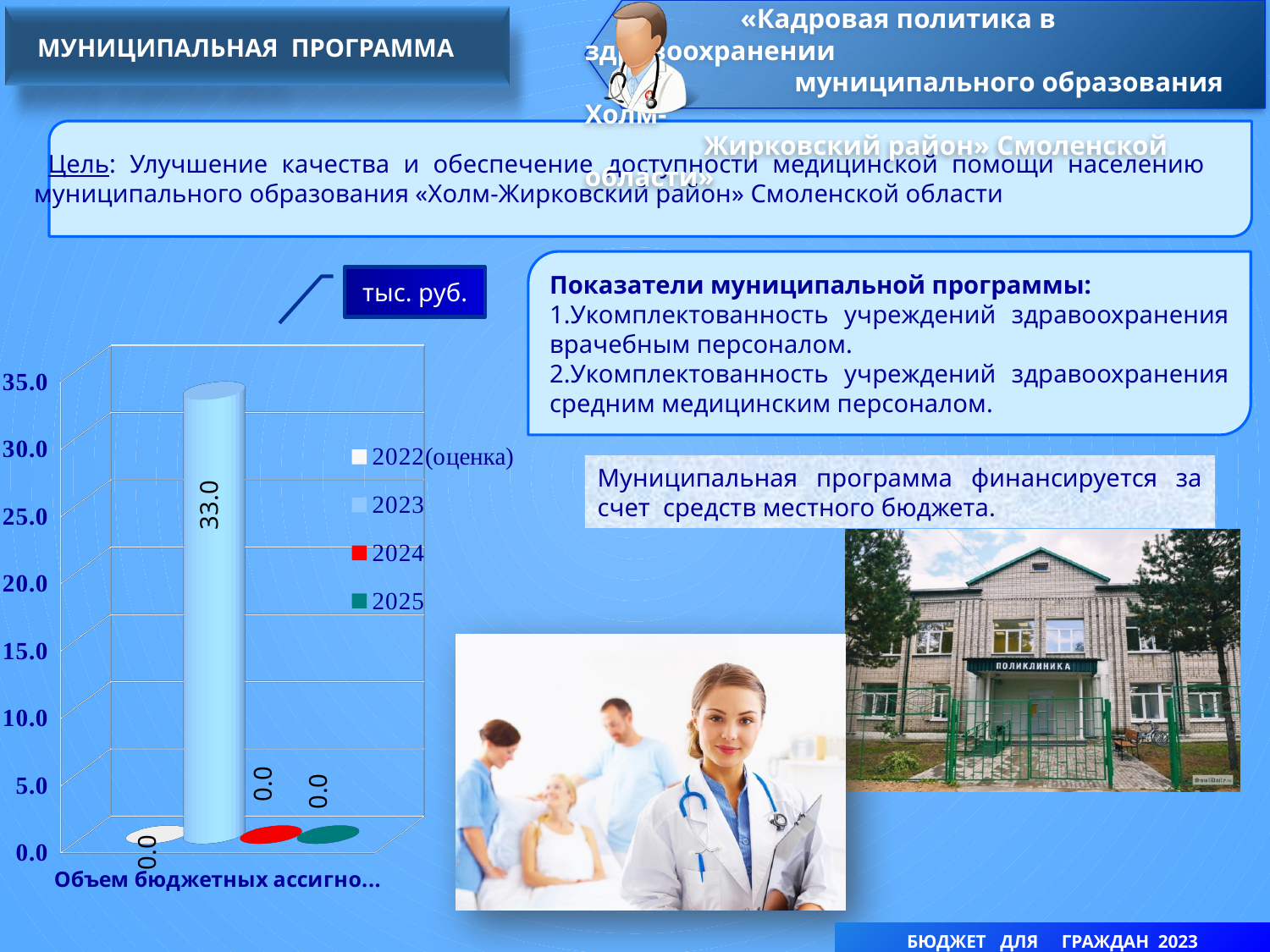
Which series has the highest value on the chart? 2023 What is the difference between the 2023 value and the 2024 value? 33.0 What is the value for the 2022(оценка) series on the chart? 0.0 Which is larger, the value for 2023 or the value for 2025? 2023 What is the value for the 2023 series on the chart? 33.0 What colour is used for the 2024 series in the chart legend? red What unit is indicated for the chart values? тыс. руб. What is the value for the 2024 series on the chart? 0.0 What is the value for the 2025 series on the chart? 0.0 How many series does the chart legend list? 4 Is the value for 2023 greater or less than 30.0? greater What kind of chart is shown on the slide? bar chart